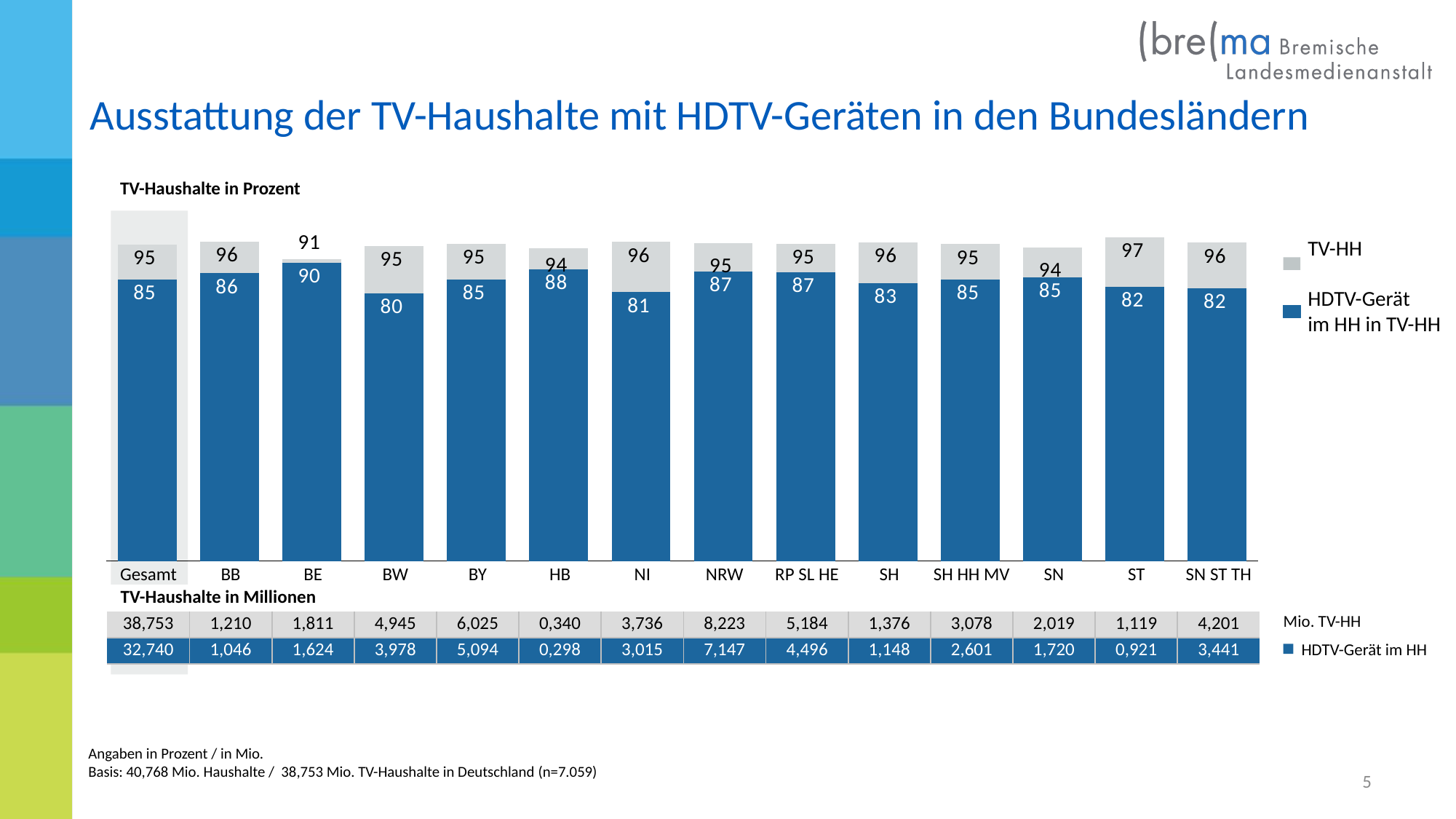
What is the TV-HH value for ST? 97 Which category has the lowest HDTV-Gerät im HH in TV-HH value? BW What is the HDTV-Gerät im HH in TV-HH value for Gesamt? 85 How many categories are shown on the x axis of the chart? 14 Which category has the highest HDTV-Gerät im HH in TV-HH value? BE What is the difference between the TV-HH value and the HDTV-Gerät im HH in TV-HH value for NI? 15 How many series does the chart legend list? 2 Which is larger, the HDTV-Gerät im HH in TV-HH value for HB or for NRW? HB What is the difference between the HDTV-Gerät im HH in TV-HH values for BE and BW? 10 What kind of chart is shown on the slide? bar chart What is the HDTV-Gerät im HH in TV-HH value for BE? 90 Which category has the lowest TV-HH value? BE